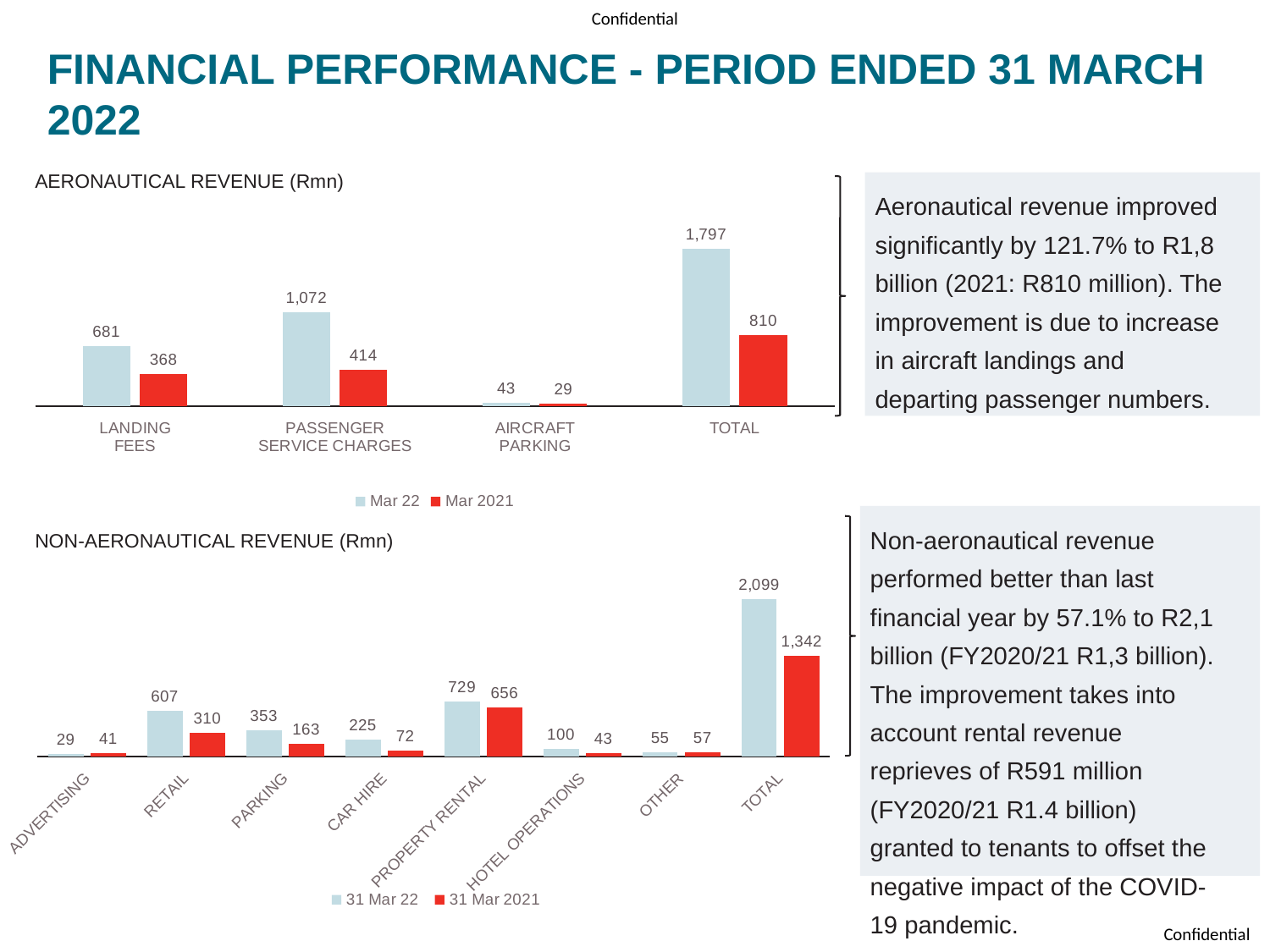
In the Aeronautical Revenue chart, what is the Mar 22 value for Passenger Service Charges? 1,072 In the Non-Aeronautical Revenue chart, what is the 31 Mar 22 value for Property Rental? 729 In the Aeronautical Revenue chart, what is the Mar 2021 value for Landing Fees? 368 What type of chart is the Non-Aeronautical Revenue chart? Bar chart How many series does the legend of the Aeronautical Revenue chart list? 2 In the Aeronautical Revenue chart, what is the difference between the Mar 22 and Mar 2021 values for Total? 987 In the Non-Aeronautical Revenue chart, which category (excluding Total) has the highest 31 Mar 22 value? Property Rental In the Aeronautical Revenue chart, which category (excluding Total) has the lowest Mar 22 value? Aircraft Parking In the Non-Aeronautical Revenue chart, is the 31 Mar 22 value for Retail larger or smaller than the 31 Mar 2021 value for Retail? Larger How many categories are shown on the x axis of the Non-Aeronautical Revenue chart? 8 In the Non-Aeronautical Revenue chart, what is the 31 Mar 2021 value for Car Hire? 72 In the Non-Aeronautical Revenue chart, what is the difference between the 31 Mar 22 and 31 Mar 2021 values for Total? 757